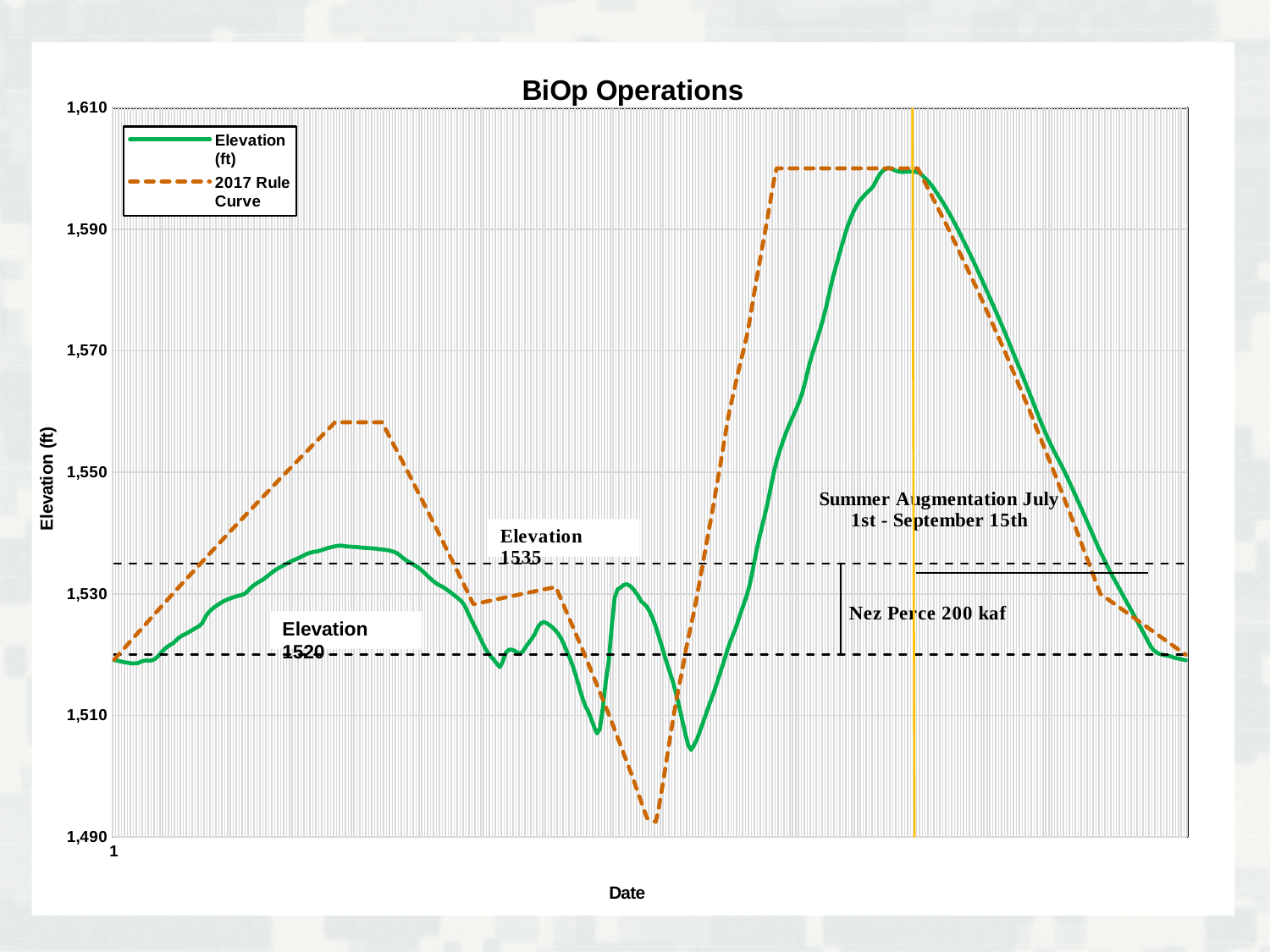
Is the first (left-hand) peak of the Elevation (ft) series greater or less than 1,550? less How many series does the legend list? 2 Is the lowest value reached by the 2017 Rule Curve greater or less than 1,510? less What kind of chart is shown on the slide? line chart Is the highest value reached by the Elevation (ft) series greater or less than 1,590? greater What is the title of the chart? BiOp Operations What is the label of the vertical axis? Elevation (ft) Which series drops to a lower minimum value, Elevation (ft) or 2017 Rule Curve? 2017 Rule Curve Which series reaches a higher value at its first (left-hand) peak, Elevation (ft) or 2017 Rule Curve? 2017 Rule Curve